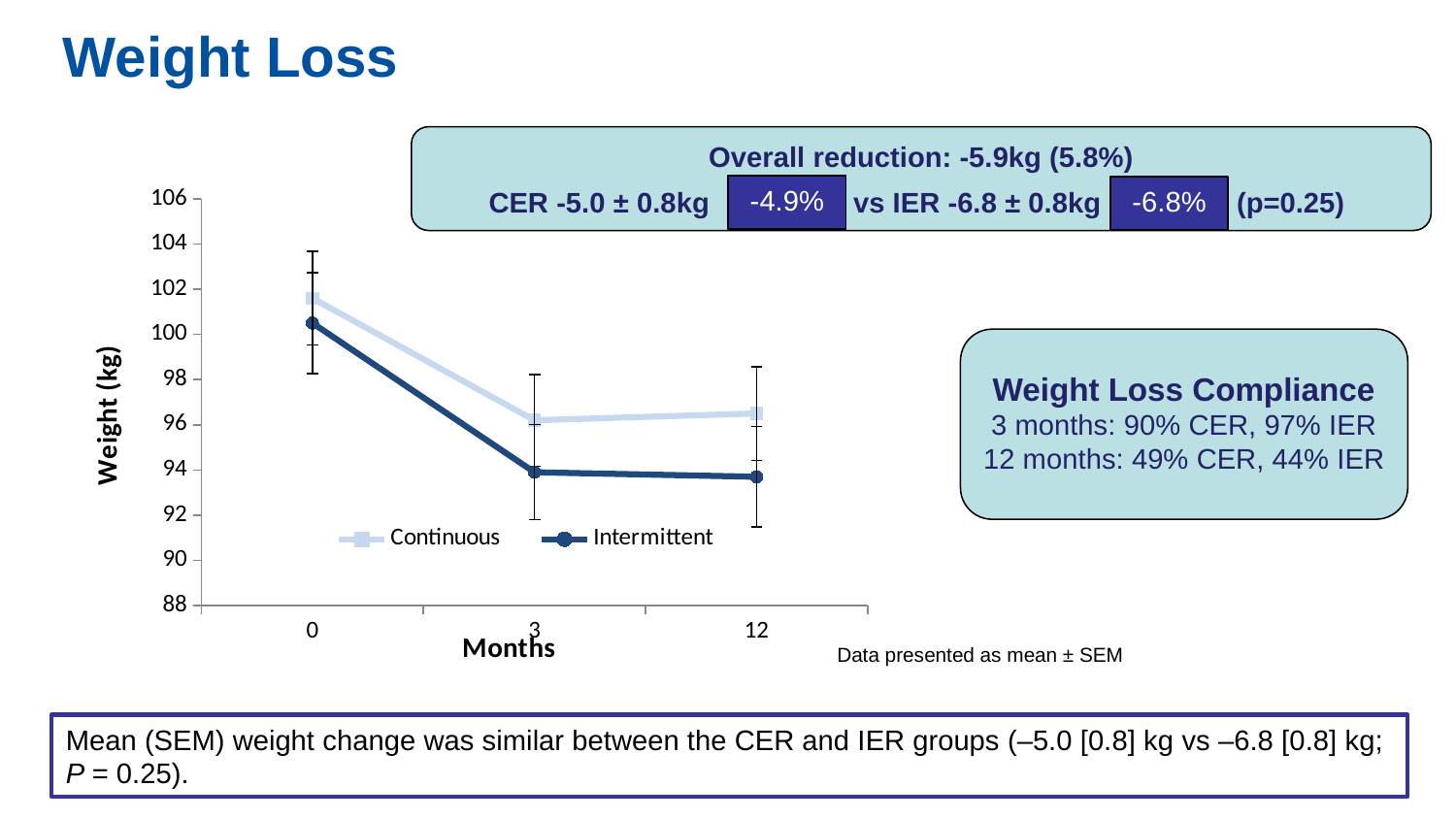
Is the Continuous series value at 3 months greater or less than 94? greater What are the two series named in the chart legend? Continuous and Intermittent What is the title of the y axis of the chart? Weight (kg) How many series does the chart legend list? 2 At 12 months, which series has the higher weight, Continuous or Intermittent? Continuous What kind of chart is shown on the slide? line chart How many time points are plotted along the x axis of the chart? 3 Does the Intermittent series rise or fall between 0 and 3 months? fall Is the Continuous series value at 0 months greater or less than 100? greater At 3 months, which series has the lower weight, Continuous or Intermittent? Intermittent Is the Intermittent series value at 0 months greater or less than 98? greater